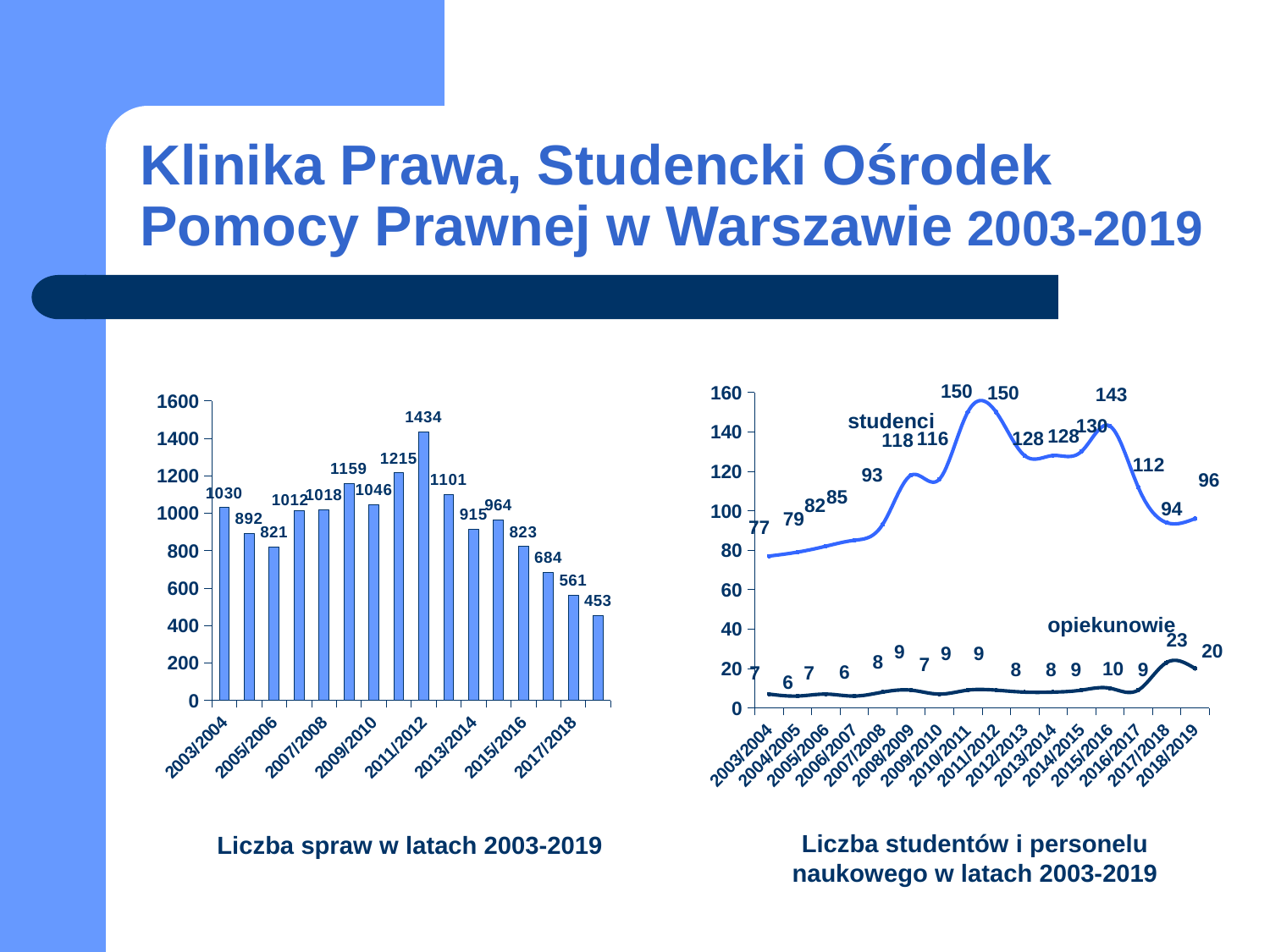
In the left chart 'Liczba spraw w latach 2003-2019', what is the difference between the values for 2003/2004 and 2017/2018? 469 In the right chart 'Liczba studentów i personelu naukowego w latach 2003-2019', how many series are plotted? 2 In the right chart 'Liczba studentów i personelu naukowego w latach 2003-2019', what is the 'studenci' value for 2018/2019? 96 What kind of chart is the left chart, 'Liczba spraw w latach 2003-2019'? bar chart In the right chart 'Liczba studentów i personelu naukowego w latach 2003-2019', is the 'studenci' value larger in 2003/2004 or in 2018/2019? 2018/2019 In the left chart 'Liczba spraw w latach 2003-2019', what is the value for 2011/2012? 1434 In the left chart 'Liczba spraw w latach 2003-2019', which year has the highest value? 2011/2012 In the left chart 'Liczba spraw w latach 2003-2019', what is the value for 2003/2004? 1030 In the left chart 'Liczba spraw w latach 2003-2019', how many bars are plotted? 16 In the left chart 'Liczba spraw w latach 2003-2019', what is the lowest value shown? 453 What kind of chart is the right chart, 'Liczba studentów i personelu naukowego w latach 2003-2019'? line chart In the right chart 'Liczba studentów i personelu naukowego w latach 2003-2019', what is the 'opiekunowie' value for 2017/2018? 23